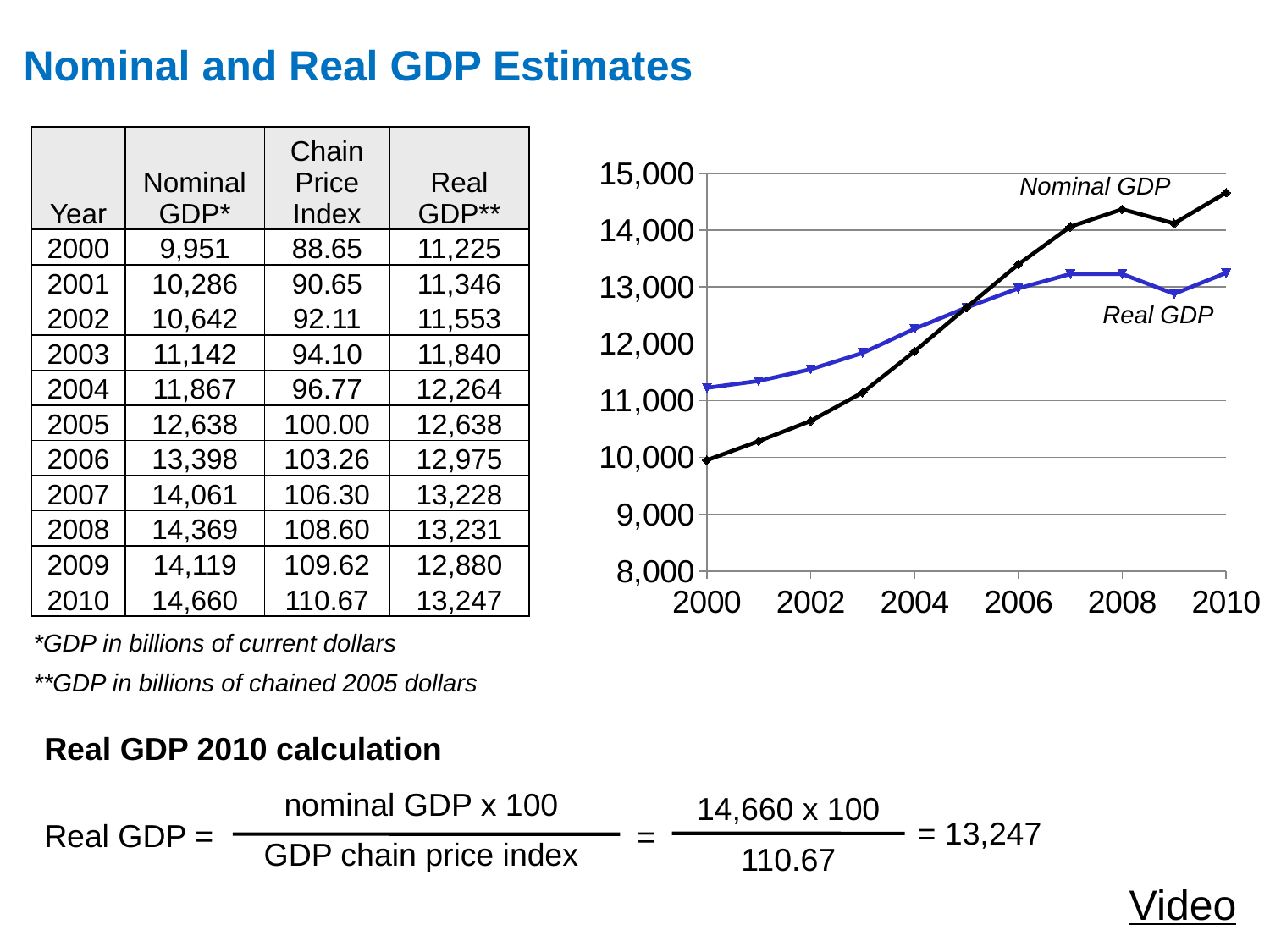
How many series are plotted on the chart? 2 In which year is Nominal GDP highest? 2010 Does Nominal GDP generally rise or fall from 2000 to 2010? rise In which year is Nominal GDP lowest? 2000 In 2000, which is larger, Nominal GDP or Real GDP? Real GDP How many years are plotted on the chart? 11 In 2010, which is larger, Nominal GDP or Real GDP? Nominal GDP What kind of chart is shown on the slide? line chart Is the Nominal GDP value for 2010 greater or less than 14,000? greater Is the Real GDP value for 2000 greater or less than 11,000? greater What is the Nominal GDP value for 2010 as printed on the slide? 14,660 Which two series are labelled on the chart? Nominal GDP and Real GDP